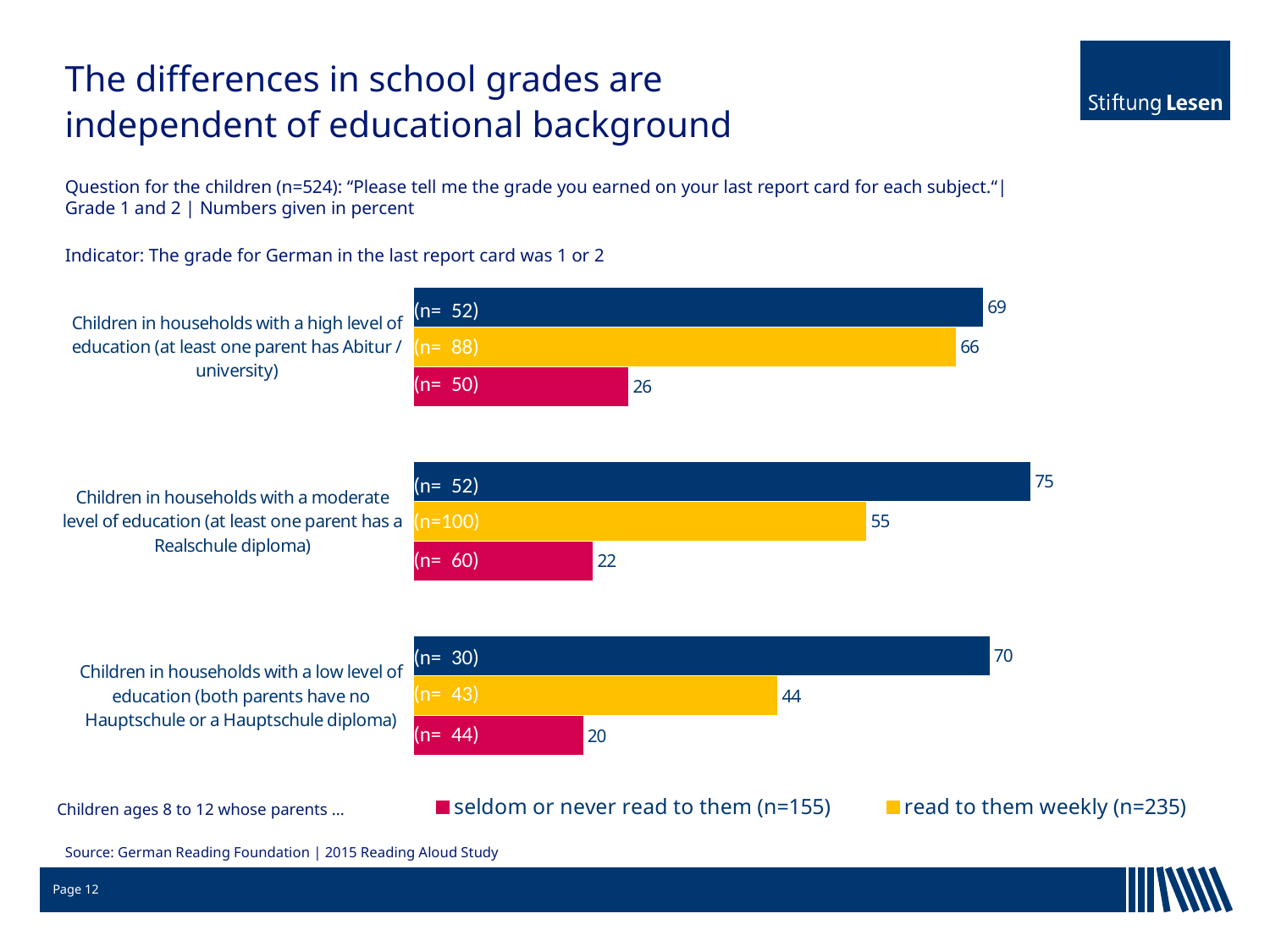
What is the value for 'read to them weekly' among children in households with a low level of education? 44 How many series does the legend list? 2 What is the value for 'read to them weekly' among children in households with a high level of education? 66 How many household education groups are shown on the chart? 3 What kind of chart is shown on the slide? bar chart Which household education group has the highest value for 'seldom or never read to them'? Children in households with a high level of education What colour are the bars for 'seldom or never read to them'? red Which household education group has the lowest value for 'read to them weekly'? Children in households with a low level of education What is the value for 'seldom or never read to them' among children in households with a moderate level of education? 22 Which is larger: the 'read to them weekly' value for the moderate education group or for the low education group? moderate education group What is the value of the blue bar for children in households with a moderate level of education? 75 What is the difference between the 'read to them weekly' and 'seldom or never read to them' values for children in households with a high level of education? 40